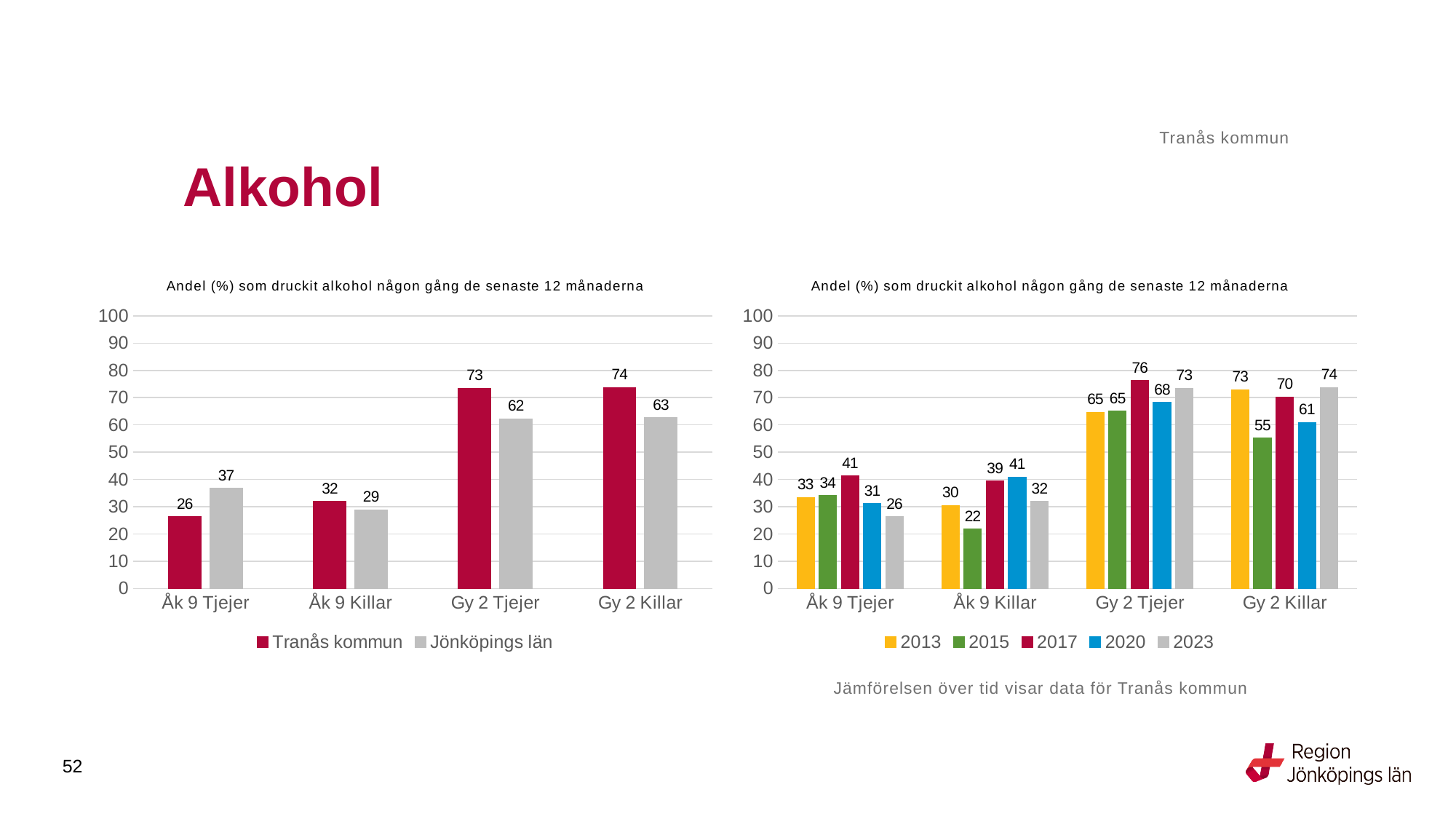
In the right chart, what is the value for 2017 for Gy 2 Tjejer? 76 In the right chart, what is the difference between 2013 and 2023 for Åk 9 Tjejer? 7 How many series does the legend of the right chart list? 5 In the left chart, what is the value for Jönköpings län for Gy 2 Killar? 63 In the left chart, what is the value for Tranås kommun for Åk 9 Tjejer? 26 In the left chart, what is the difference between Tranås kommun and Jönköpings län for Gy 2 Tjejer? 11 What kind of chart is the right chart? Bar chart How many series does the legend of the left chart list? 2 In the right chart, what is the value for 2015 for Åk 9 Killar? 22 In the right chart, which year has the lowest value for Gy 2 Killar? 2015 In the left chart, which is larger for Åk 9 Tjejer: Tranås kommun or Jönköpings län? Jönköpings län In the left chart, which category has the highest value for Tranås kommun? Gy 2 Killar